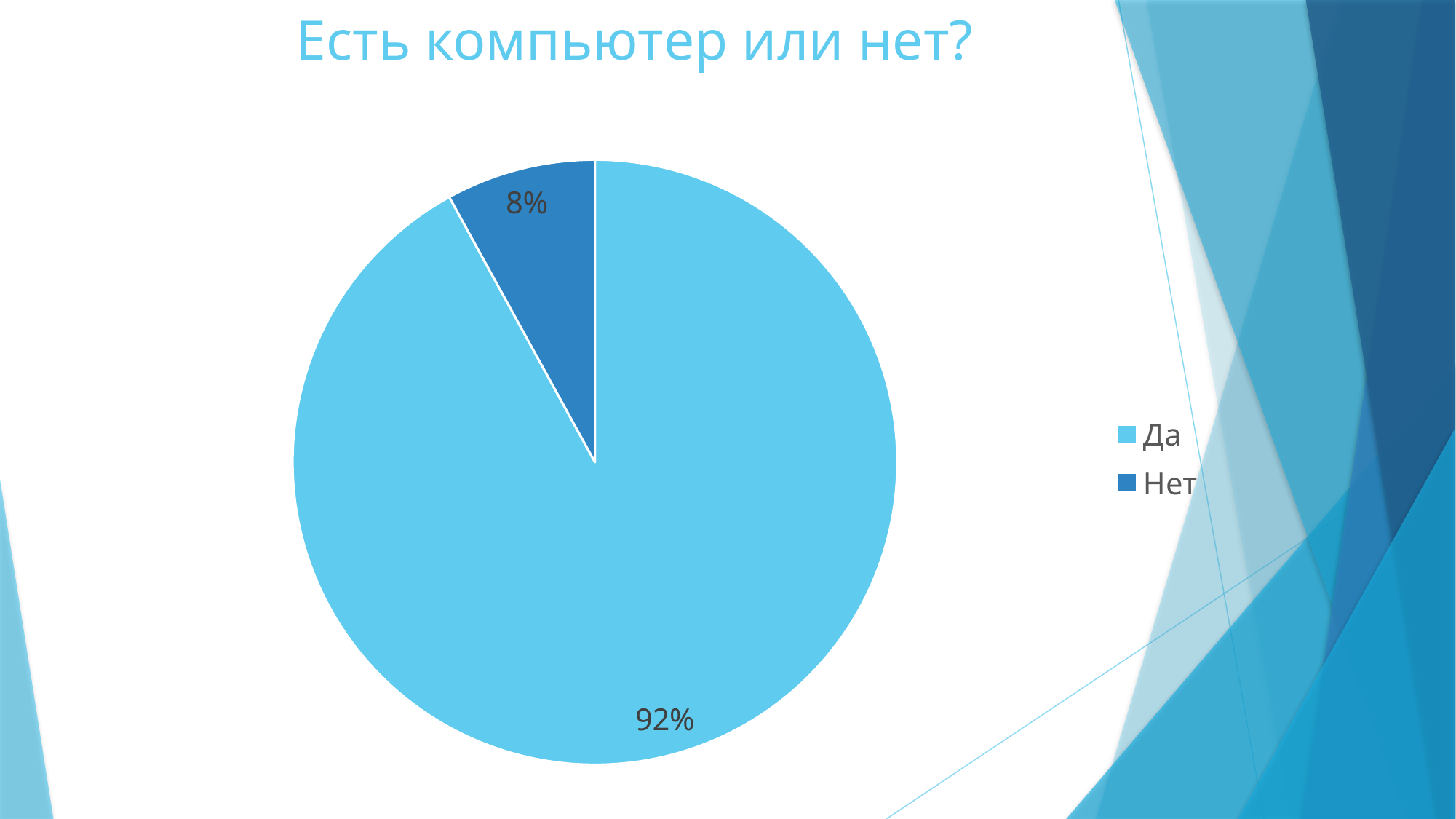
What is the difference in percentage points between the "Да" and "Нет" slices? 84 What is the title of the chart? Есть компьютер или нет? Which category has the smallest slice of the pie? Нет Which legend entry is shown in the darker blue colour? Нет Which is larger, the "Да" slice or the "Нет" slice? Да What percentage is shown for the "Да" slice? 92% Which category has the largest slice of the pie? Да How many entries does the legend list? 2 What percentage is shown for the "Нет" slice? 8% How many slices does the pie chart have? 2 What share of the pie does the "Нет" slice represent? 8% What kind of chart is shown on the slide? pie chart